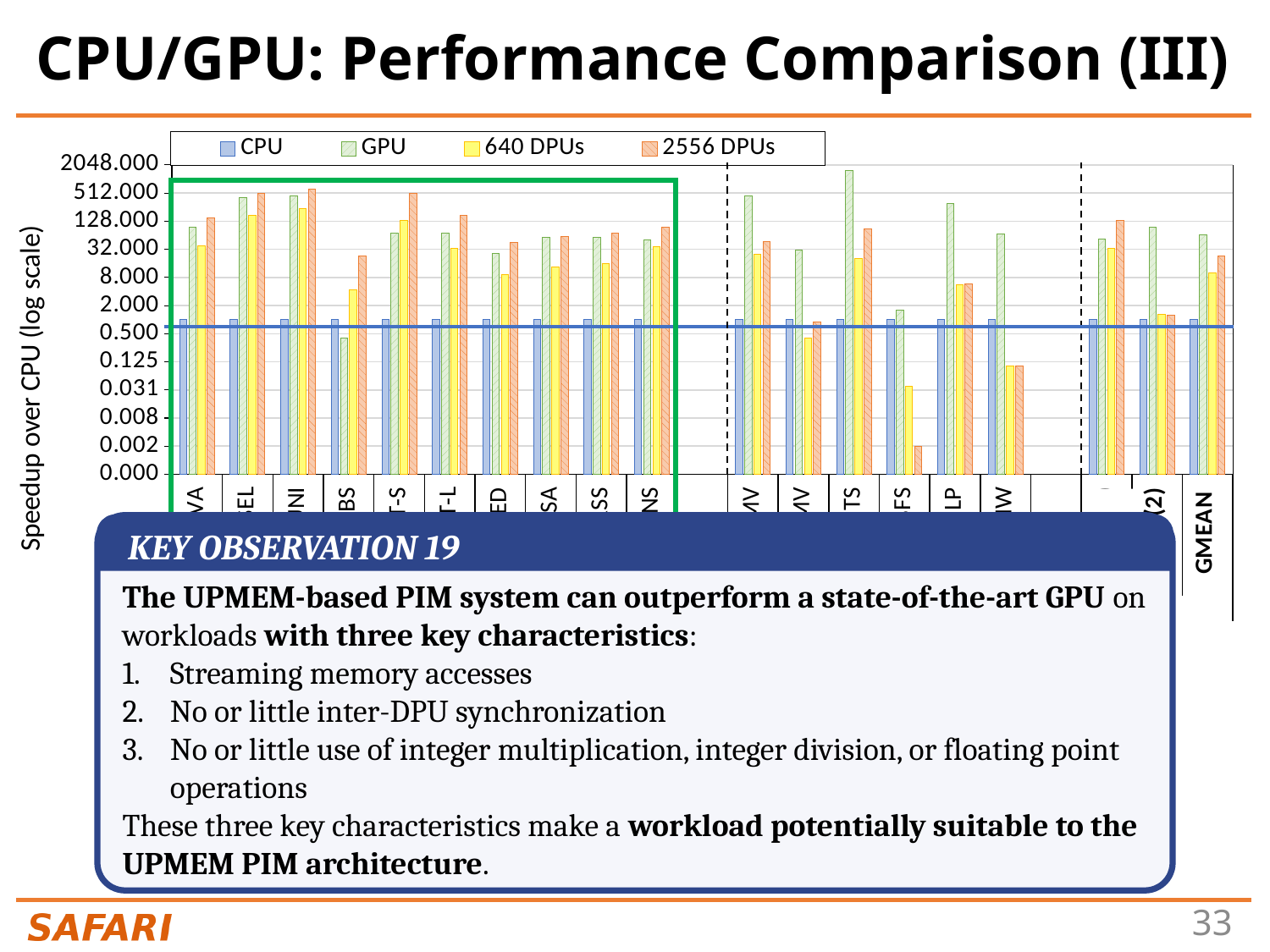
Is the 640 DPUs value for GMEAN greater or less than 2? greater Is the GPU value for BS greater or less than 0.5? less What are the series names listed in the chart legend? CPU, GPU, 640 DPUs, 2556 DPUs Is the GPU value for TS greater or less than 512? greater For BS, which is larger: the GPU value or the 2556 DPUs value? 2556 DPUs What is the label of the chart's vertical axis? Speedup over CPU (log scale) How many series does the chart legend list? 4 For TS, which is larger: the GPU value or the 2556 DPUs value? GPU Which series has the highest value for TS? GPU What kind of chart is shown on the slide? bar chart